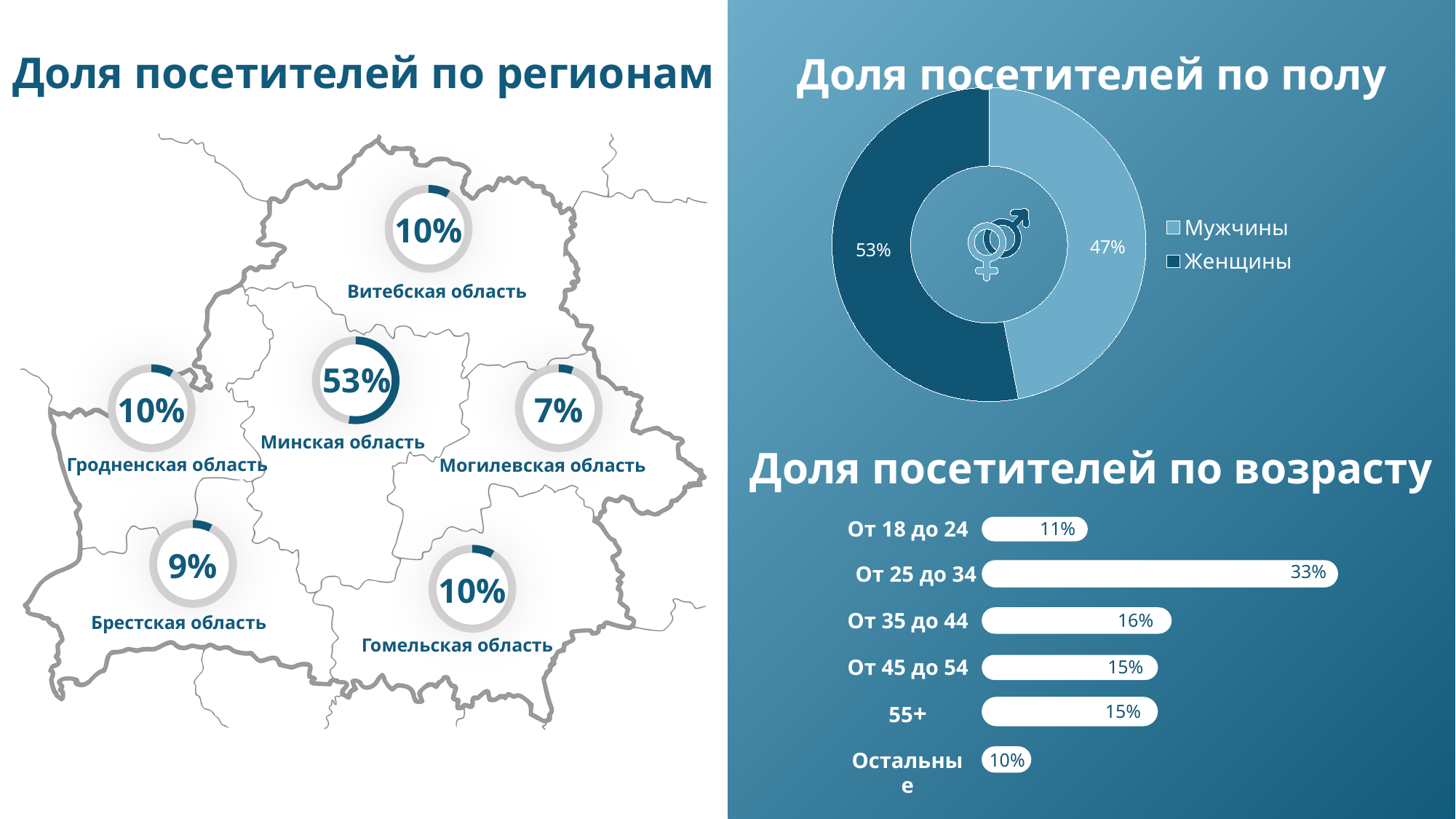
In the chart 'Доля посетителей по возрасту', what is the value for 'От 25 до 34'? 33% In the map 'Доля посетителей по регионам', what is the share for Могилевская область? 7% In the chart 'Доля посетителей по полу', what share of visitors are Женщины? 53% In the chart 'Доля посетителей по возрасту', what is the difference between 'От 25 до 34' and 'От 18 до 24'? 22% What kind of chart is 'Доля посетителей по полу'? Donut chart In the chart 'Доля посетителей по полу', how many entries does the legend list? 2 What kind of chart is 'Доля посетителей по возрасту'? Bar chart In the map 'Доля посетителей по регионам', which region has the highest share of visitors? Минская область In the chart 'Доля посетителей по возрасту', which age group has the highest share? От 25 до 34 In the chart 'Доля посетителей по возрасту', how many age categories are shown? 6 In the chart 'Доля посетителей по полу', which group has the larger share, Мужчины or Женщины? Женщины In the chart 'Доля посетителей по полу', what share of visitors are Мужчины? 47%